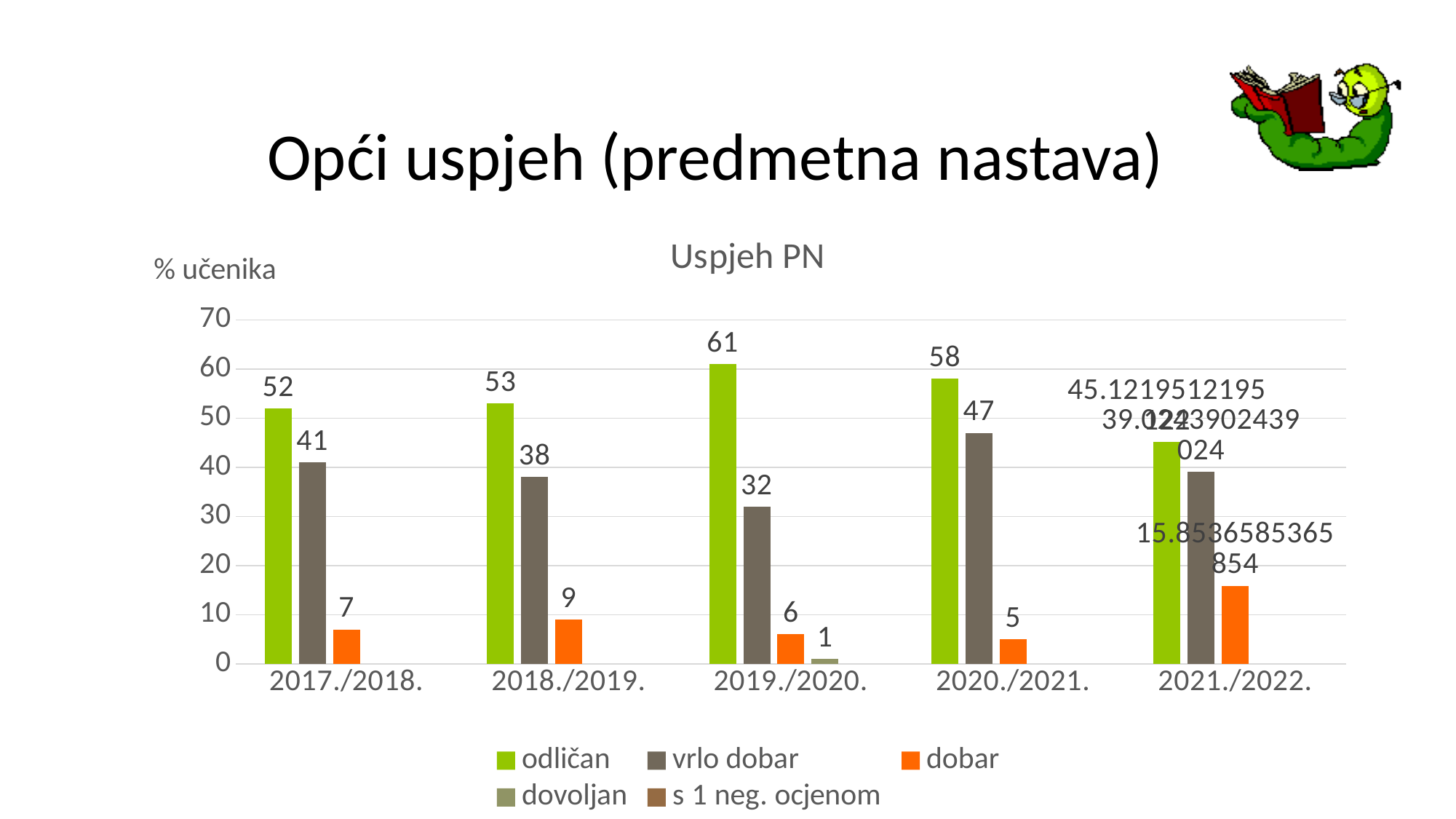
How many school years are shown on the x axis? 5 What is the value for vrlo dobar in 2020./2021.? 47 Which is larger in 2018./2019., odličan or vrlo dobar? odličan What is the value for dobar in 2018./2019.? 9 Is the value for odličan in 2021./2022. greater or less than 50? less How many series does the legend list? 5 What is the title of the chart? Uspjeh PN In which school year is the dobar value lowest? 2020./2021. What is the difference between the odličan and vrlo dobar values in 2017./2018.? 11 In which school year is the odličan value highest? 2019./2020. What is the value for odličan in 2019./2020.? 61 What type of chart is shown on the slide? bar chart